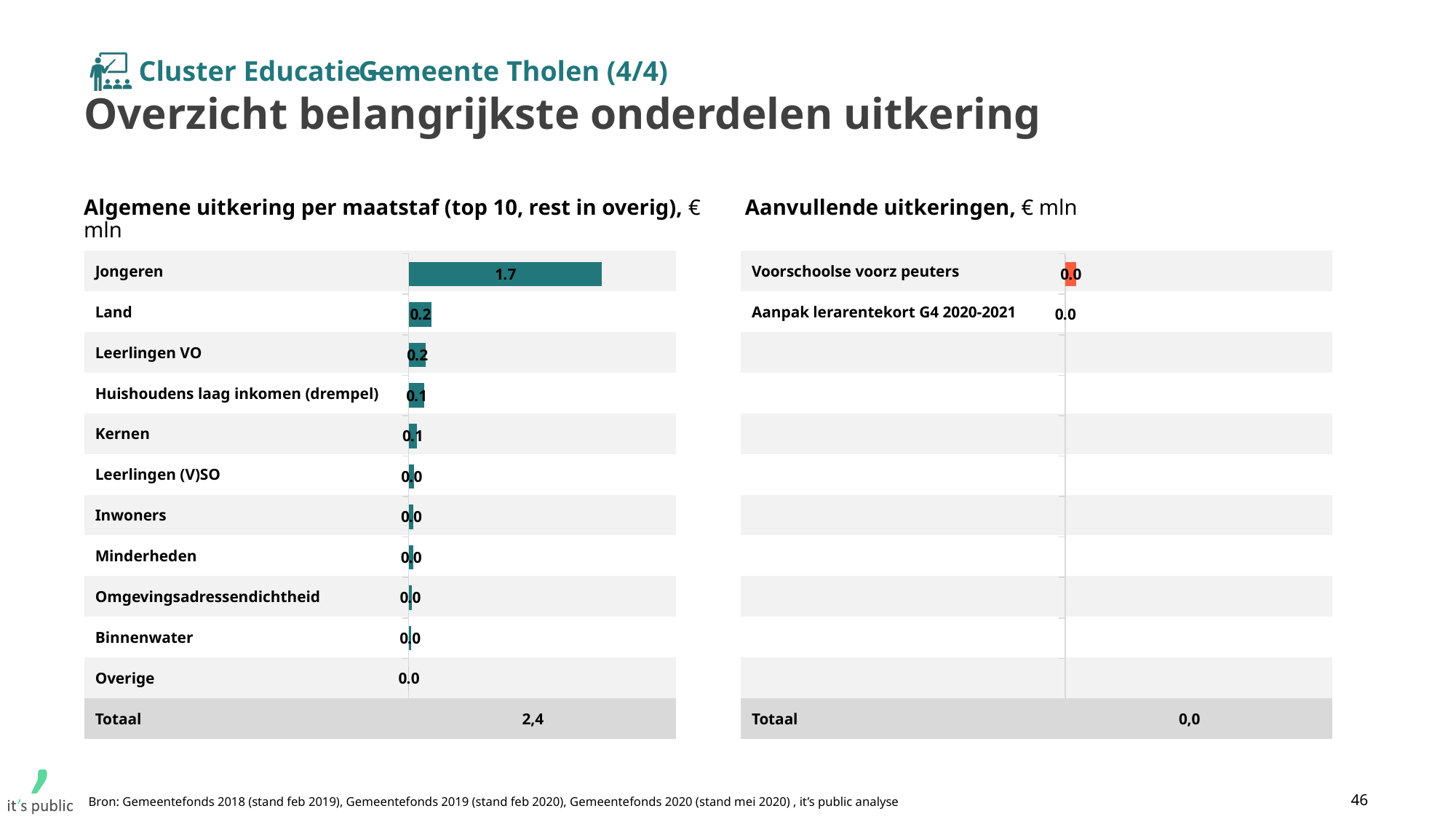
In the chart 'Aanvullende uitkeringen', what is the value for Voorschoolse voorz peuters? 0.0 How many categories (excluding the Totaal row) are listed in the chart 'Algemene uitkering per maatstaf'? 11 In the chart 'Algemene uitkering per maatstaf', which category has the highest value? Jongeren In the chart 'Algemene uitkering per maatstaf', what is the value for Jongeren? 1.7 In the chart 'Algemene uitkering per maatstaf', which is larger: the value for Jongeren or the value for Kernen? Jongeren In the chart 'Algemene uitkering per maatstaf', what is the difference between the values for Jongeren and Land? 1.5 In the chart 'Algemene uitkering per maatstaf', what is the value for Land? 0.2 What is the Totaal shown for the chart 'Algemene uitkering per maatstaf'? 2,4 In the chart 'Algemene uitkering per maatstaf', what is the value for Huishoudens laag inkomen (drempel)? 0.1 What unit is stated in the title of the chart 'Aanvullende uitkeringen'? € mln What kind of chart is the left chart 'Algemene uitkering per maatstaf'? Bar chart How many categories (excluding the Totaal row) are listed in the chart 'Aanvullende uitkeringen'? 2